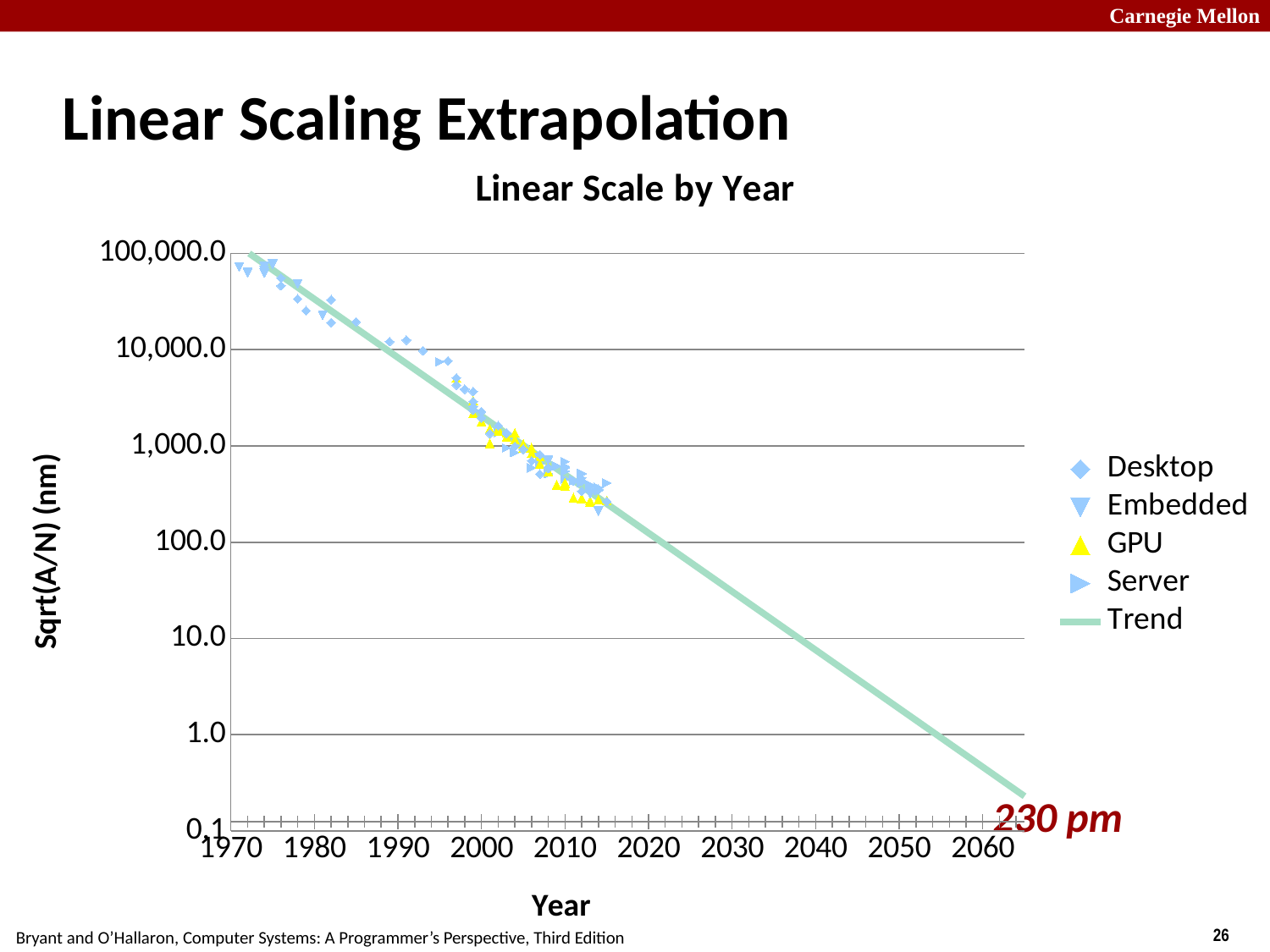
Are the GPU values plotted around 2012 greater or less than 1,000.0? less Do the plotted values rise or fall as the year increases along the x axis? Fall Are the Embedded values plotted in the early 1970s greater or less than 10,000.0? greater What is the highest value labelled on the vertical axis? 100,000.0 How many series does the legend list? 5 Is the Trend line value at 2040 greater or less than 100.0? less What value is annotated in red at the lower right end of the Trend line? 230 pm What kind of chart is shown on the slide? Scatter chart What is the label of the vertical axis? Sqrt(A/N) (nm) What is the title of the chart? Linear Scale by Year